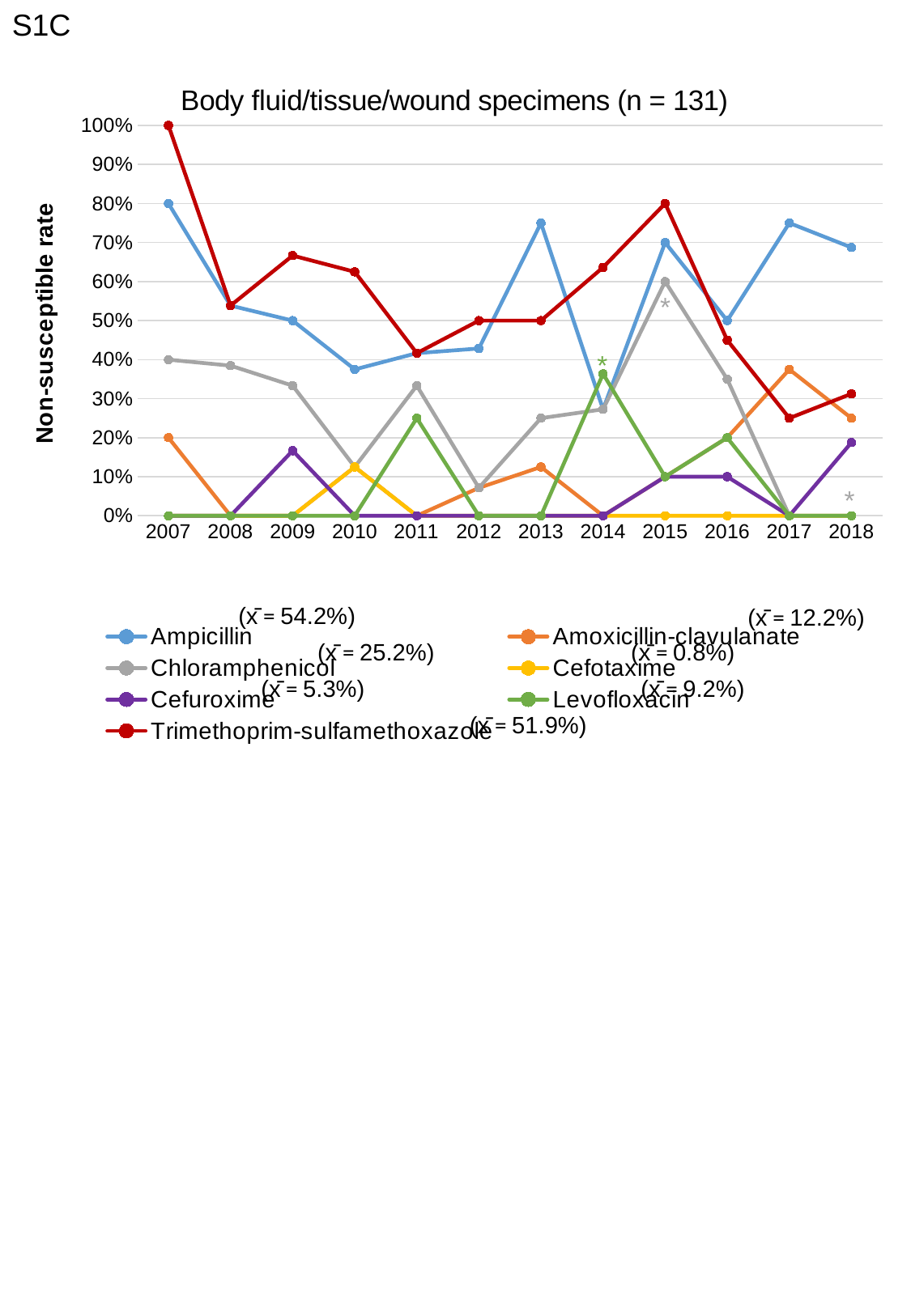
What is the non-susceptible rate for Ampicillin in 2007? 80% How many years are shown on the x axis? 12 Is the value for Trimethoprim-sulfamethoxazole in 2017 greater or less than 30%? less What mean value is shown in the legend for Ampicillin? 54.2% What kind of chart is shown on the slide? line chart Is the value for Ampicillin in 2013 greater or less than 70%? greater Which series has the highest non-susceptible rate in 2007? Trimethoprim-sulfamethoxazole What is the non-susceptible rate for Chloramphenicol in 2015? 60% What is the non-susceptible rate for Trimethoprim-sulfamethoxazole in 2007? 100% Which series has the highest non-susceptible rate in 2017? Ampicillin How many series does the legend list? 7 What is the non-susceptible rate for Cefotaxime in 2018? 0%